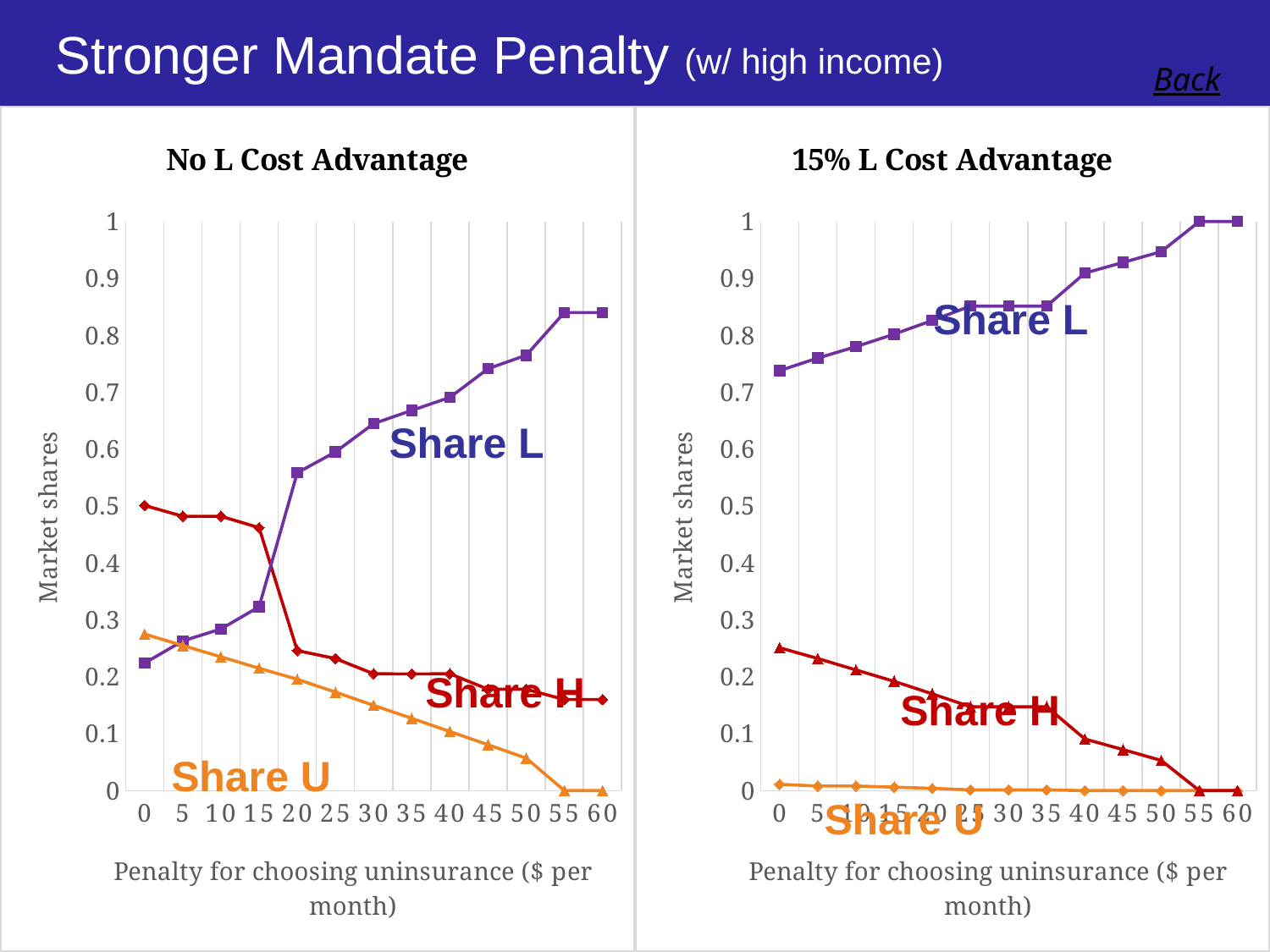
How many penalty values are plotted along the x axis of the "No L Cost Advantage" chart? 13 In the "15% L Cost Advantage" chart, is the value of Share L at a penalty of 0 greater or less than 0.7? greater In the "No L Cost Advantage" chart, is the value of Share L at a penalty of 60 greater or less than 0.8? greater What kind of chart is the "No L Cost Advantage" chart? line chart In the "No L Cost Advantage" chart, what is the value of Share U at a penalty of 60? 0 In the "15% L Cost Advantage" chart, which is larger at a penalty of 30: Share H or Share U? Share H How many series are plotted in the "15% L Cost Advantage" chart? 3 In the "No L Cost Advantage" chart, which series has the highest value at a penalty of 0? Share H In the "No L Cost Advantage" chart, is the value of Share H at a penalty of 20 greater or less than 0.3? less In the "15% L Cost Advantage" chart, what is the value of Share L at a penalty of 60? 1 In the "No L Cost Advantage" chart, does Share L rise or fall as the penalty increases? rises In the "15% L Cost Advantage" chart, what is the value of Share H at a penalty of 55? 0